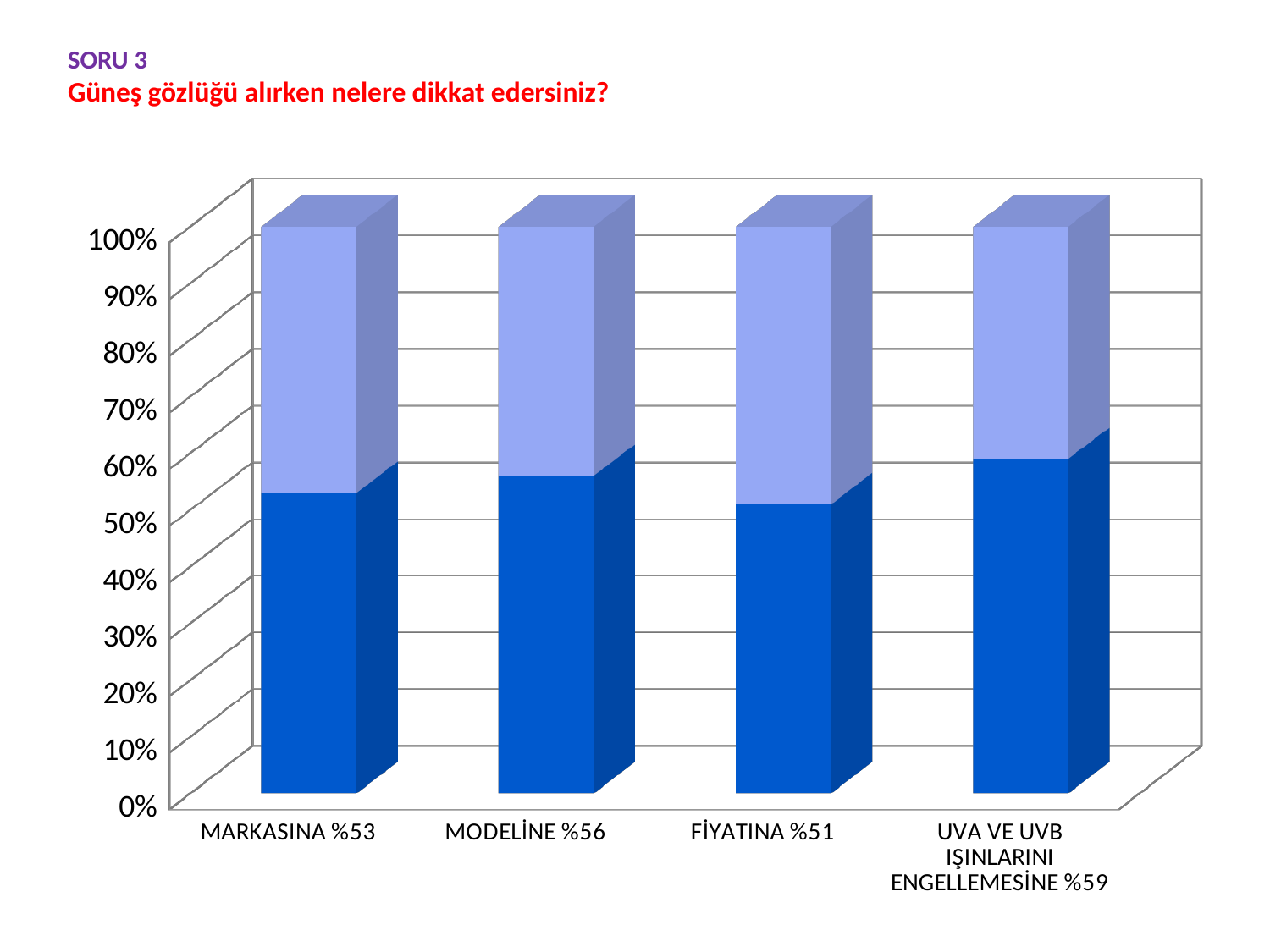
Is the dark blue segment for UVA VE UVB IŞINLARINI ENGELLEMESİNE greater or less than 50%? greater What percentage is given for UVA VE UVB IŞINLARINI ENGELLEMESİNE in the chart? %59 How many categories are shown on the x axis of the chart? 4 What percentage is given for FİYATINA in the chart? %51 What is the difference between the percentages for UVA VE UVB IŞINLARINI ENGELLEMESİNE and FİYATINA? 8 What is the total height of each stacked bar in the chart? 100% What percentage is given for MARKASINA in the chart? %53 What kind of chart is shown on the slide? bar chart Which has a larger percentage, MODELİNE or MARKASINA? MODELİNE Which category has the highest percentage in the chart? UVA VE UVB IŞINLARINI ENGELLEMESİNE Which category has the lowest percentage in the chart? FİYATINA What percentage is given for MODELİNE in the chart? %56